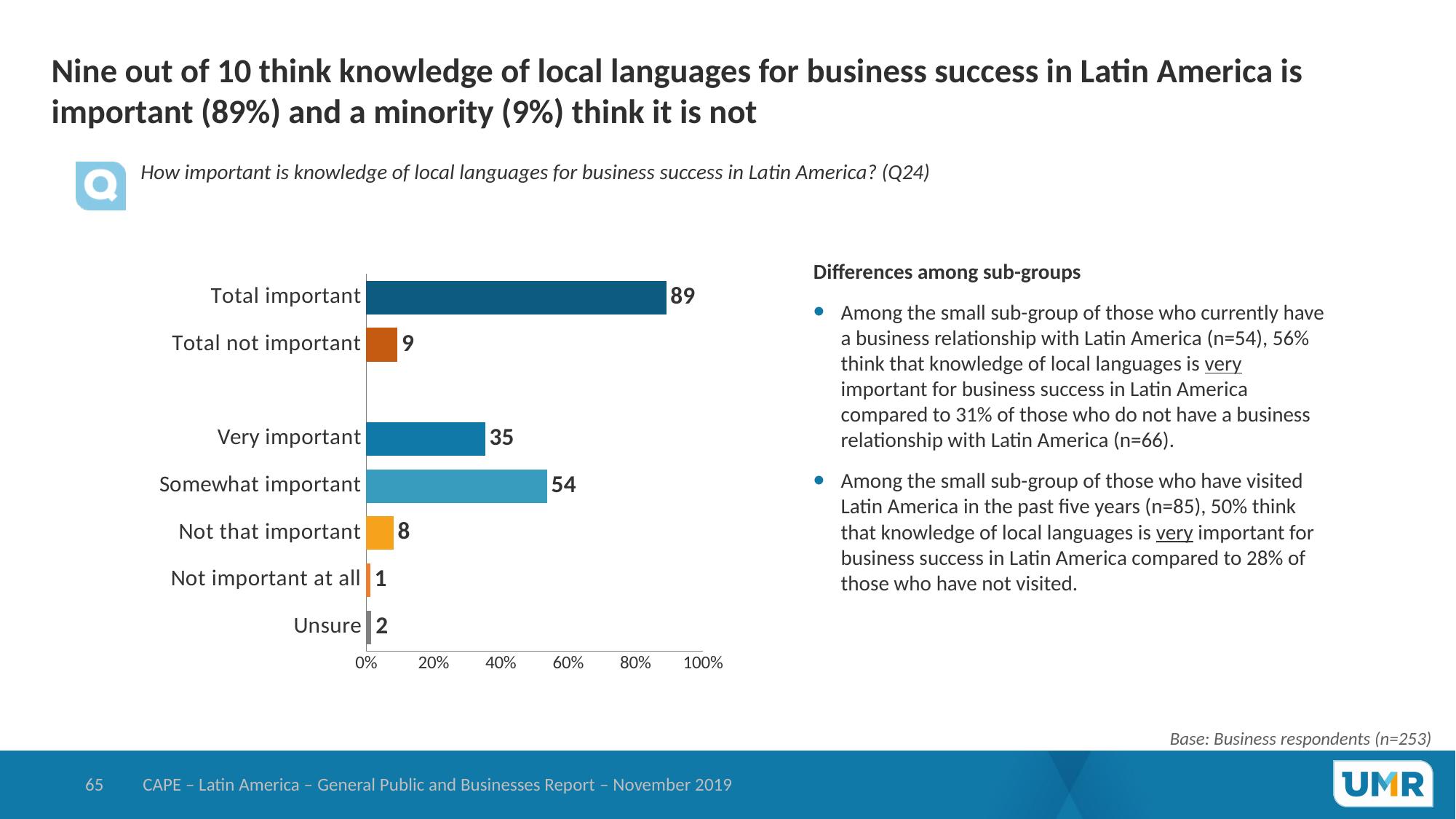
What is the value for Total important? 89 Which category has the highest value? Total important How many categories are shown in the chart? 7 What kind of chart is shown on the slide? bar chart What is the value for Not that important? 8 What is the difference between Somewhat important and Very important? 19 Is the value for Very important greater or less than 40%? less What is the value for Somewhat important? 54 What is the value for Unsure? 2 Which category has the lowest value? Not important at all What is the highest value shown on the x axis? 100% Which is larger, Total not important or Not that important? Total not important